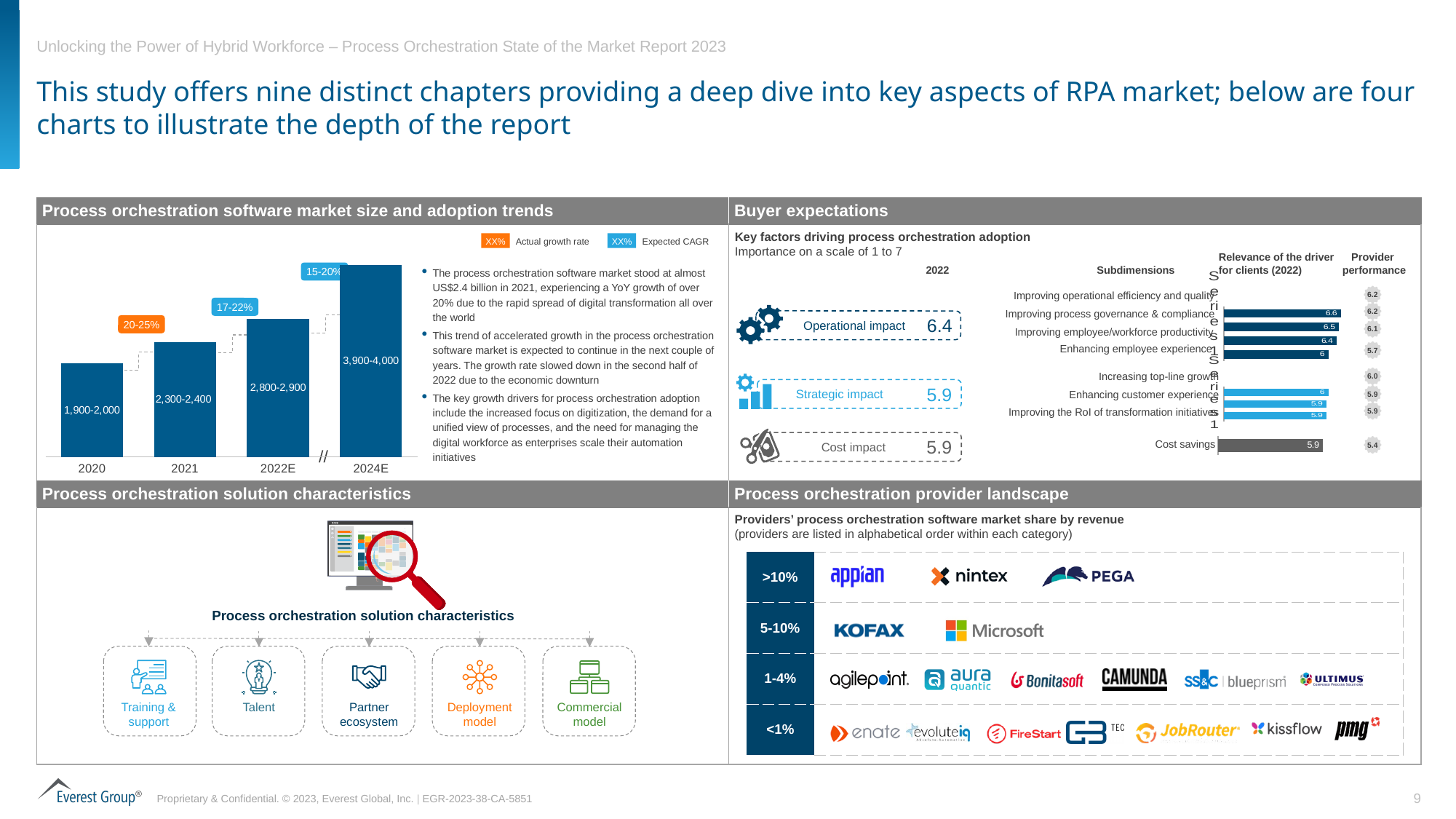
In the 'Process orchestration software market size and adoption trends' chart, how many years are shown on the x axis? 4 In the 'Process orchestration software market size and adoption trends' chart, do the bars rise or fall from 2020 to 2024E? rise In the 'Process orchestration software market size and adoption trends' chart, what is the market size label for 2020? 1,900-2,000 In the 'Process orchestration software market size and adoption trends' chart, what is the market size label for 2024E? 3,900-4,000 In the 'Buyer expectations' chart, what is the highest relevance value shown on any bar? 6.6 In the 'Buyer expectations' chart, what is the relevance of the driver for clients (2022) for Cost savings? 5.9 In the 'Buyer expectations' panel, what is the importance score shown for Operational impact? 6.4 What kind of chart is used in the 'Process orchestration software market size and adoption trends' panel? bar chart In the 'Buyer expectations' chart, what is the provider performance score for Cost savings? 5.4 In the 'Process orchestration software market size and adoption trends' chart, what actual growth rate is shown between 2020 and 2021? 20-25% In the 'Process orchestration software market size and adoption trends' chart, what is the market size label for 2021? 2,300-2,400 In the 'Process orchestration software market size and adoption trends' chart, what expected CAGR is shown between 2022E and 2024E? 15-20%